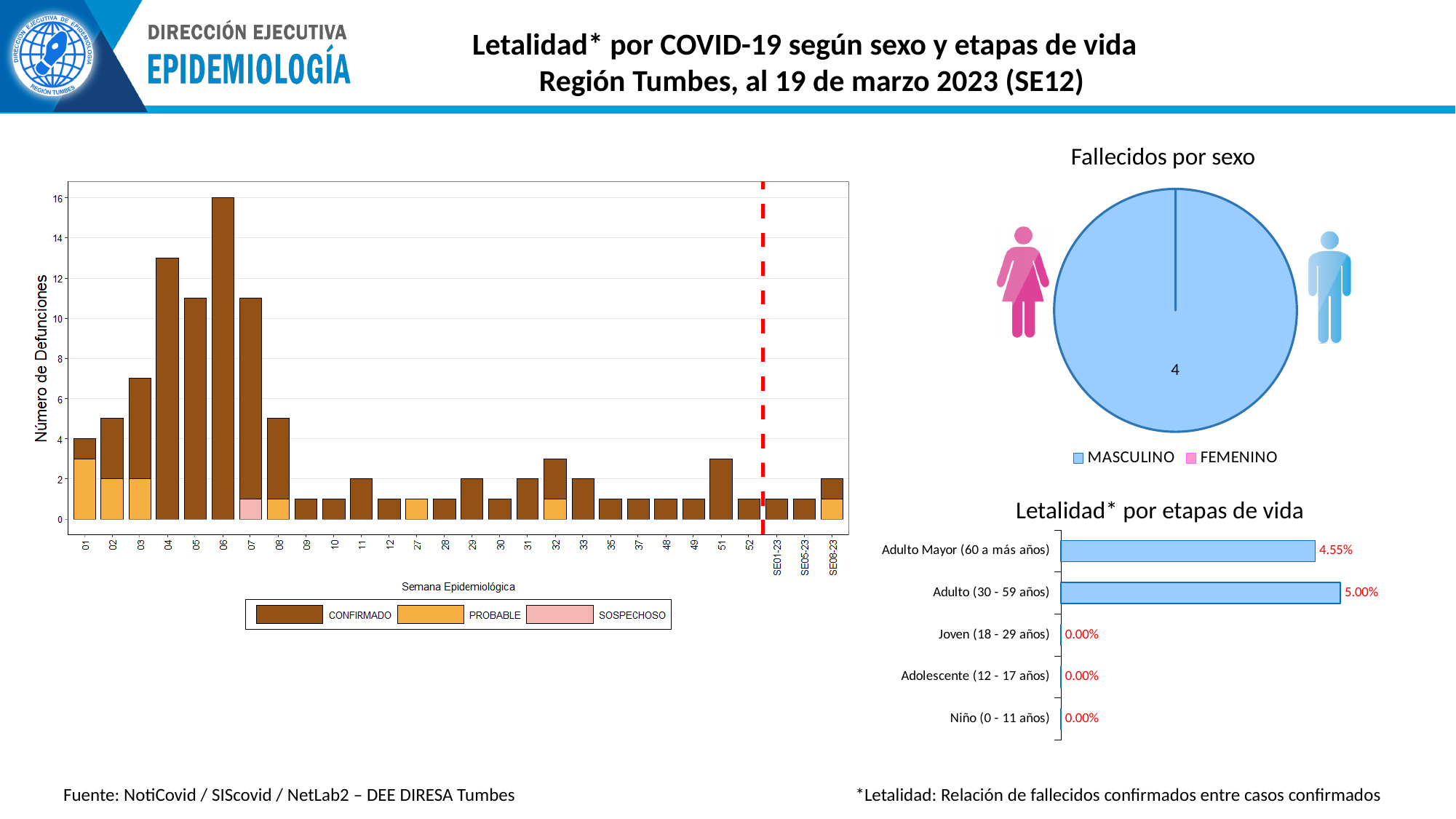
In the 'Fallecidos por sexo' pie chart, which sex accounts for the larger share of deaths? MASCULINO In the 'Letalidad* por etapas de vida' chart, what is the value for Joven (18 - 29 años)? 0.00% In the 'Número de Defunciones' chart on the left, what is the total number of deaths in week 06? 16 In the 'Número de Defunciones' chart on the left, which epidemiological week has the highest number of deaths? 06 In the 'Letalidad* por etapas de vida' chart, how many age groups are shown? 5 In the 'Letalidad* por etapas de vida' chart, which age group has the highest lethality? Adulto (30 - 59 años) In the 'Número de Defunciones' chart on the left, how many series does the legend list? 3 In the 'Letalidad* por etapas de vida' chart, what is the difference between the values for Adulto (30 - 59 años) and Adulto Mayor (60 a más años)? 0.45% In the 'Letalidad* por etapas de vida' chart, what is the value for Adulto (30 - 59 años)? 5.00% In the 'Letalidad* por etapas de vida' chart, what is the value for Adulto Mayor (60 a más años)? 4.55% In the 'Fallecidos por sexo' pie chart, how many series does the legend list? 2 In the 'Fallecidos por sexo' pie chart, what value is shown for MASCULINO? 4